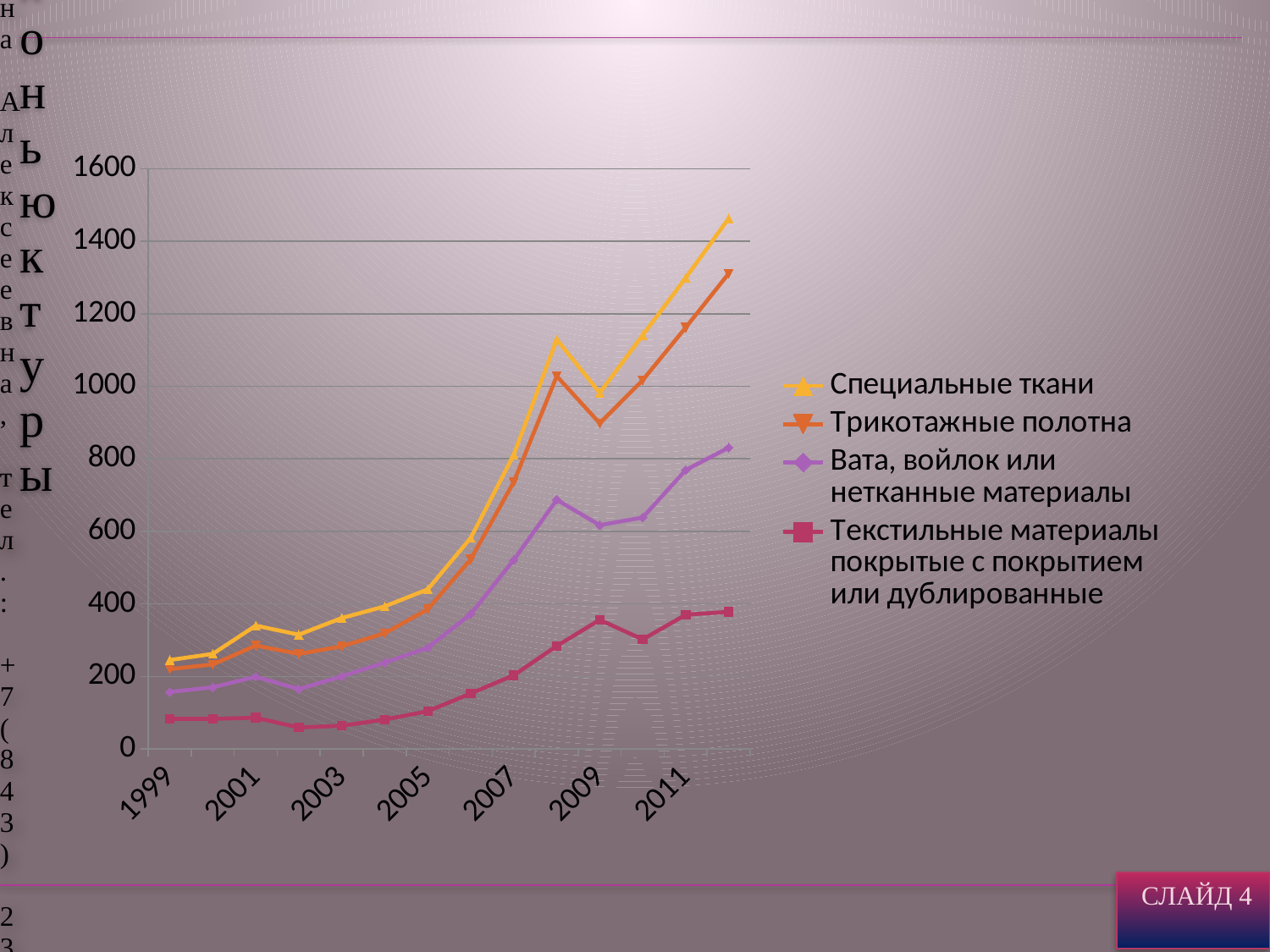
What kind of chart is shown on the slide? line chart Which series is drawn with the yellow line? Специальные ткани Is the value for Трикотажные полотна in 2009 greater or less than 1000? less Does the Специальные ткани series rise or fall from 1999 to 2007? rise In 2005, which is larger: Вата, войлок или нетканные материалы or Текстильные материалы покрытые с покрытием или дублированные? Вата, войлок или нетканные материалы Does the Специальные ткани series rise or fall between 2008 and 2009? fall Is the value for Текстильные материалы покрытые с покрытием или дублированные in 2011 greater or less than 200? greater How many series does the legend list? 4